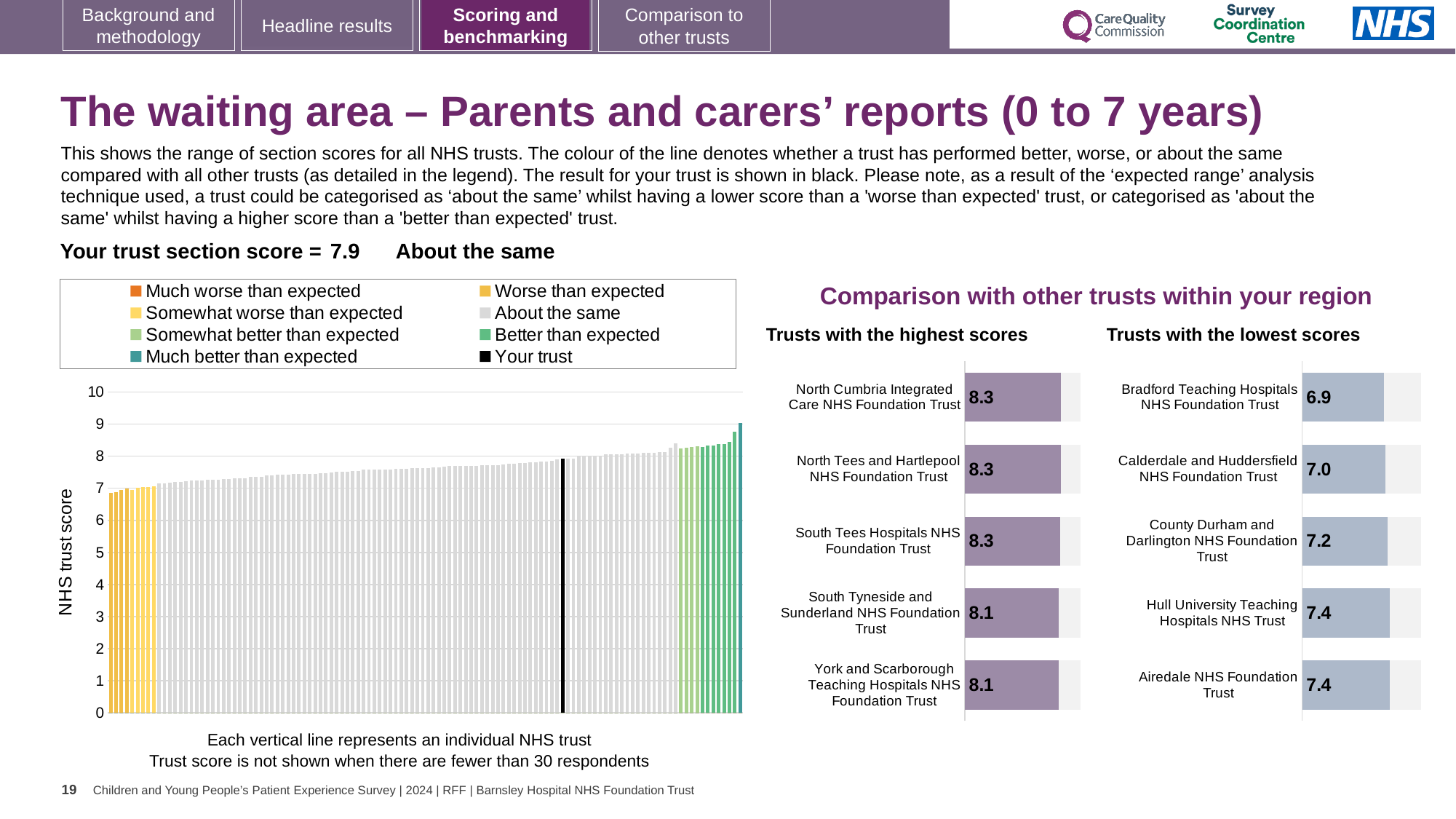
In the 'Trusts with the highest scores' chart, what is the difference between the scores of North Tees and Hartlepool NHS Foundation Trust and York and Scarborough Teaching Hospitals NHS Foundation Trust? 0.2 What kind of chart is the main chart on the left showing NHS trust scores? Bar chart What is the label of the y axis on the main chart on the left? NHS trust score How many trusts are listed in the 'Trusts with the highest scores' chart? 5 How many entries does the legend of the main NHS trust score chart list? 8 In the 'Trusts with the lowest scores' chart, which has the higher score: Calderdale and Huddersfield NHS Foundation Trust or County Durham and Darlington NHS Foundation Trust? County Durham and Darlington NHS Foundation Trust In the main NHS trust score chart, do the values rise or fall from left to right? Rise In the 'Trusts with the highest scores' chart, what is the score for North Cumbria Integrated Care NHS Foundation Trust? 8.3 In the main NHS trust score chart, is the value for the tallest bar greater or less than 8? greater In the 'Trusts with the lowest scores' chart, which trust has the lowest score? Bradford Teaching Hospitals NHS Foundation Trust In the 'Trusts with the lowest scores' chart, what is the difference between the scores of Hull University Teaching Hospitals NHS Trust and Bradford Teaching Hospitals NHS Foundation Trust? 0.5 In the 'Trusts with the lowest scores' chart, what is the score for Bradford Teaching Hospitals NHS Foundation Trust? 6.9